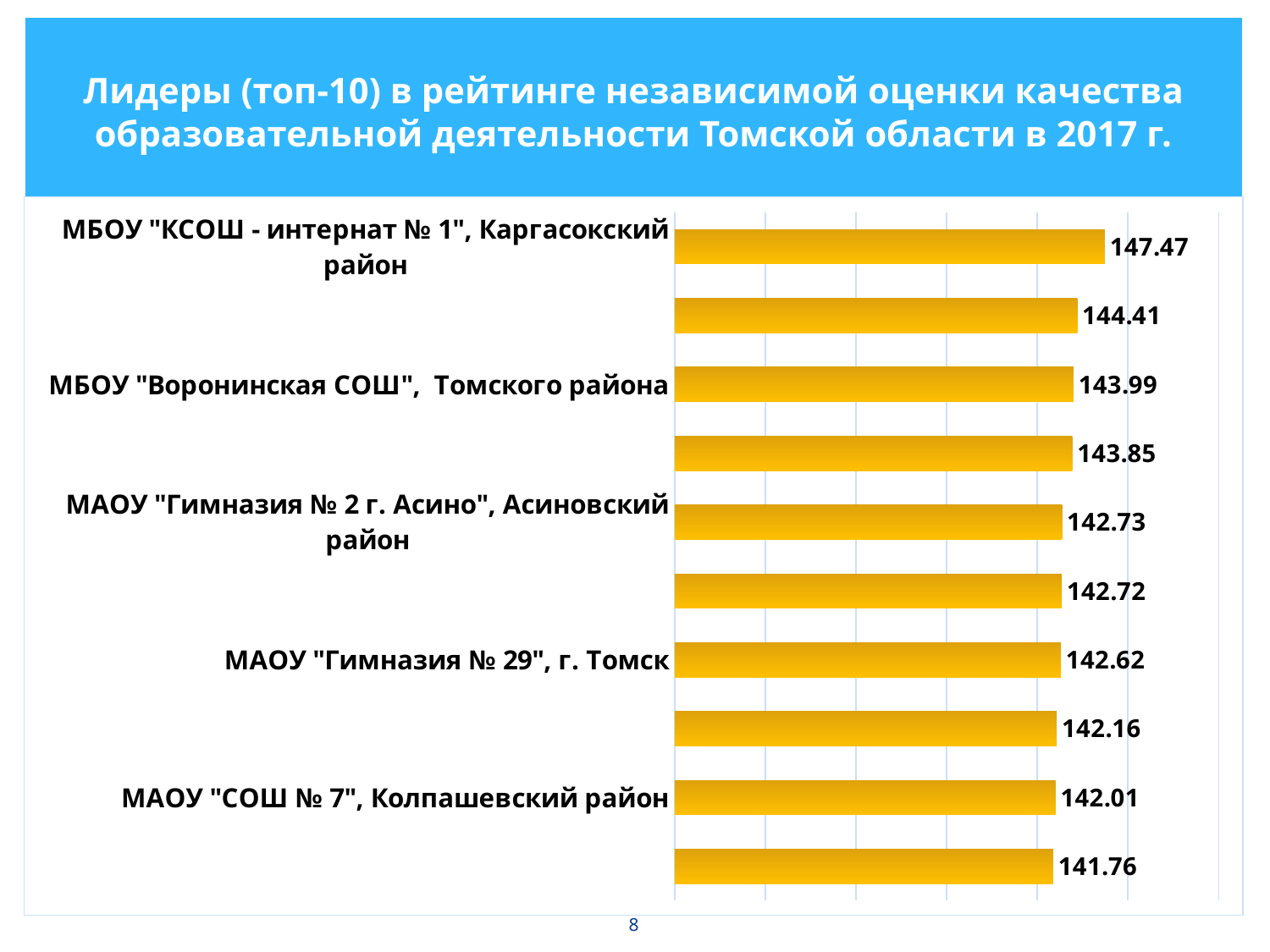
Which school has the highest value in the chart? МБОУ "КСОШ - интернат № 1", Каргасокский район What type of chart is shown on the slide? bar chart What is the difference between the values for МБОУ "КСОШ - интернат № 1", Каргасокский район and МАОУ "СОШ № 7", Колпашевский район? 5.46 What is the value for МАОУ "Гимназия № 29", г. Томск? 142.62 What is the value for МБОУ "КСОШ - интернат № 1", Каргасокский район? 147.47 How many bars are shown in the chart? 10 What is the value for МАОУ "Гимназия № 2 г. Асино", Асиновский район? 142.73 Do the bar values increase or decrease from the top of the chart to the bottom? decrease Which has a larger value: МБОУ "Воронинская СОШ", Томского района or МАОУ "Гимназия № 29", г. Томск? МБОУ "Воронинская СОШ", Томского района What is the value for МБОУ "Воронинская СОШ", Томского района? 143.99 What is the lowest value shown in the chart? 141.76 What is the value for МАОУ "СОШ № 7", Колпашевский район? 142.01